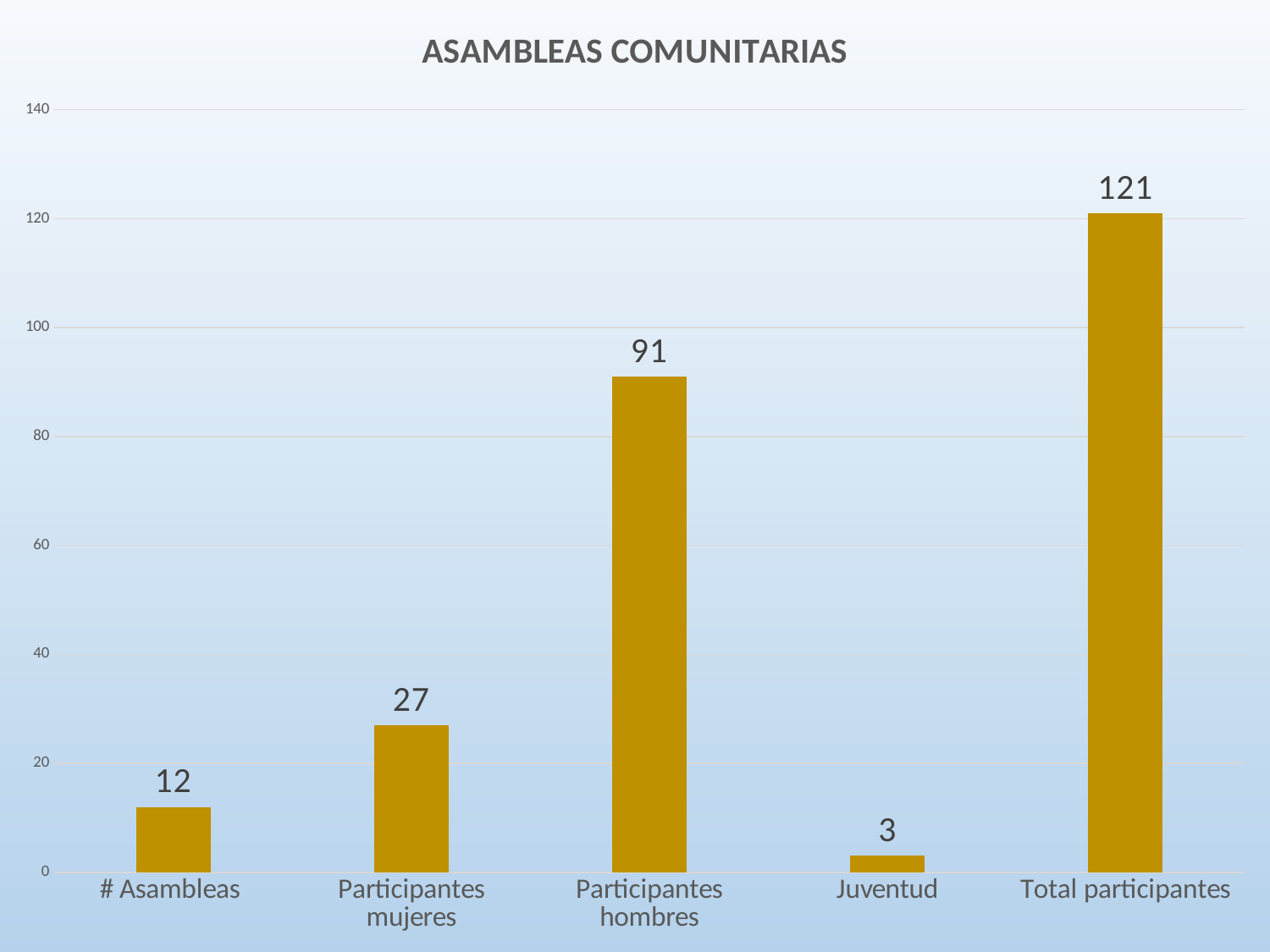
What is the value for Participantes hombres? 91 What is the value for Juventud? 3 What is the value for Participantes mujeres? 27 How many categories are shown on the chart? 5 Which category has the highest value? Total participantes What is the value for # Asambleas? 12 Which is larger, Participantes mujeres or # Asambleas? Participantes mujeres What is the difference between Participantes hombres and Participantes mujeres? 64 Is the value for Total participantes greater or less than 100? greater What is the title of the chart? ASAMBLEAS COMUNITARIAS What kind of chart is this? Bar chart Which category has the lowest value? Juventud